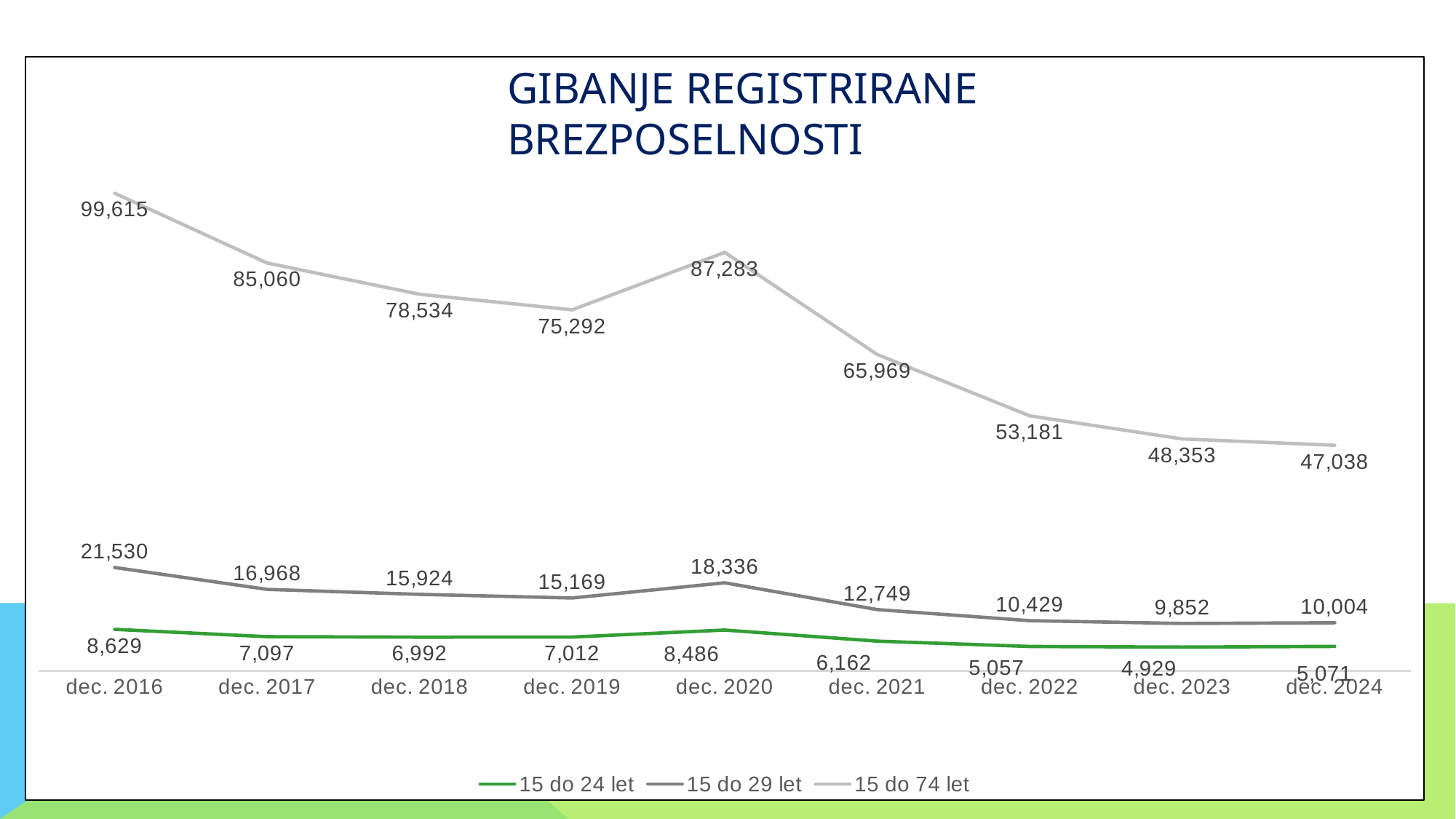
In which year does the 15 do 24 let series reach its highest value? dec. 2016 What is the value for the 15 do 29 let series in dec. 2020? 18,336 How many series does the legend list? 3 What is the value for the 15 do 24 let series in dec. 2023? 4,929 Does the 15 do 74 let series generally rise or fall from dec. 2016 to dec. 2024? fall In which year does the 15 do 74 let series reach its lowest value? dec. 2024 What is the title of the chart? GIBANJE REGISTRIRANE BREZPOSELNOSTI Which is larger for the 15 do 29 let series: dec. 2023 or dec. 2024? dec. 2024 What kind of chart is shown on the slide? line chart How many time points are shown on the x axis? 9 What is the value for the 15 do 74 let series in dec. 2016? 99,615 What is the difference between the 15 do 74 let values in dec. 2016 and dec. 2024? 52,577